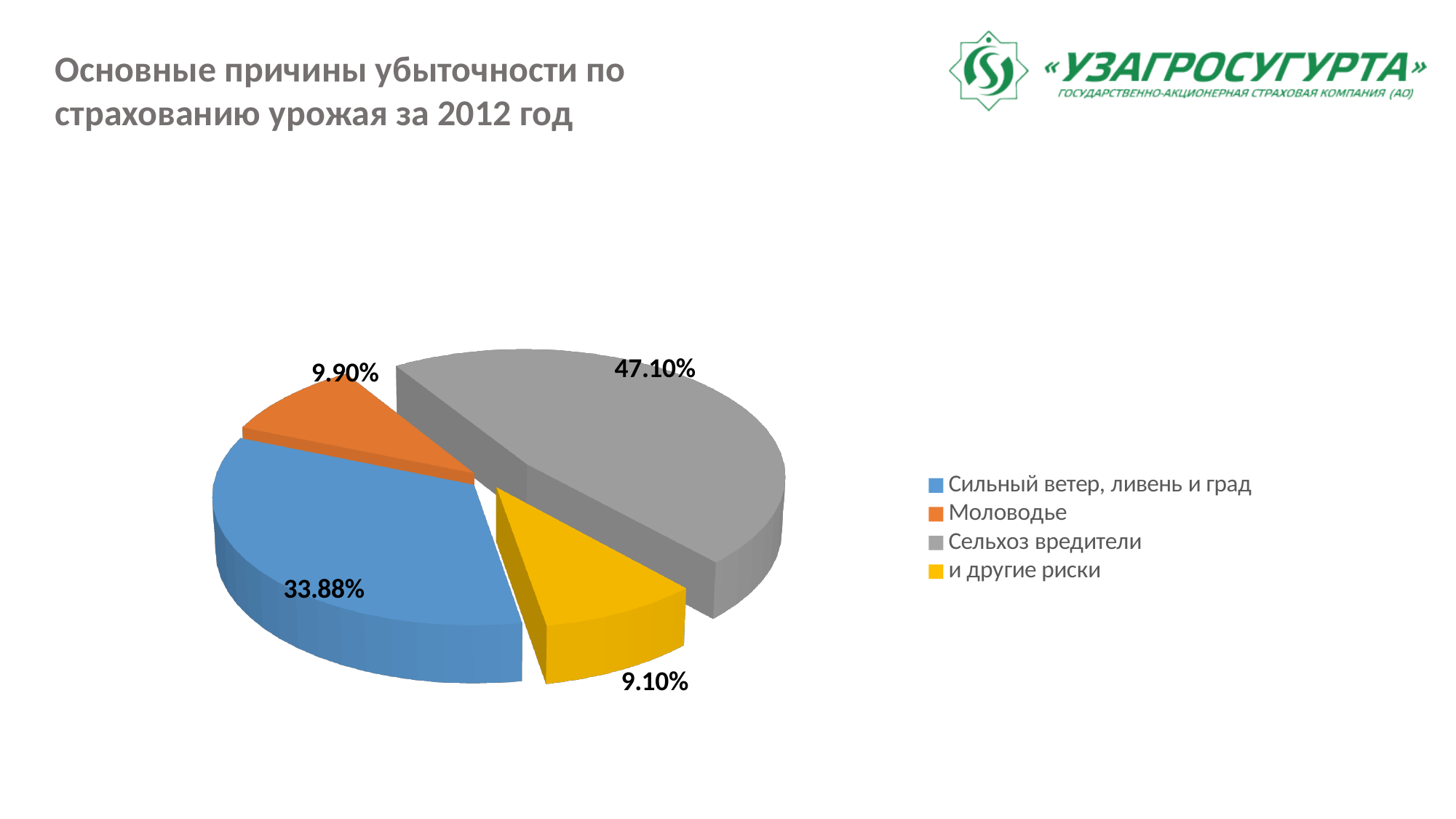
What colour is the slice for "Сельхоз вредители"? Gray What share of the pie does "Сильный ветер, ливень и град" have? 33.88% How many entries does the legend list? 4 What share of the pie does "Сельхоз вредители" have? 47.10% What kind of chart is shown on the slide? Pie chart How many slices does the pie chart have? 4 What share of the pie does "и другие риски" have? 9.10% What share of the pie does "Моловодье" have? 9.90% Which is larger: the share of "Моловодье" or the share of "и другие риски"? Моловодье Which category has the largest share of the pie? Сельхоз вредители Which category has the smallest share of the pie? и другие риски What is the difference between the shares of "Сельхоз вредители" and "Сильный ветер, ливень и град"? 13.22%